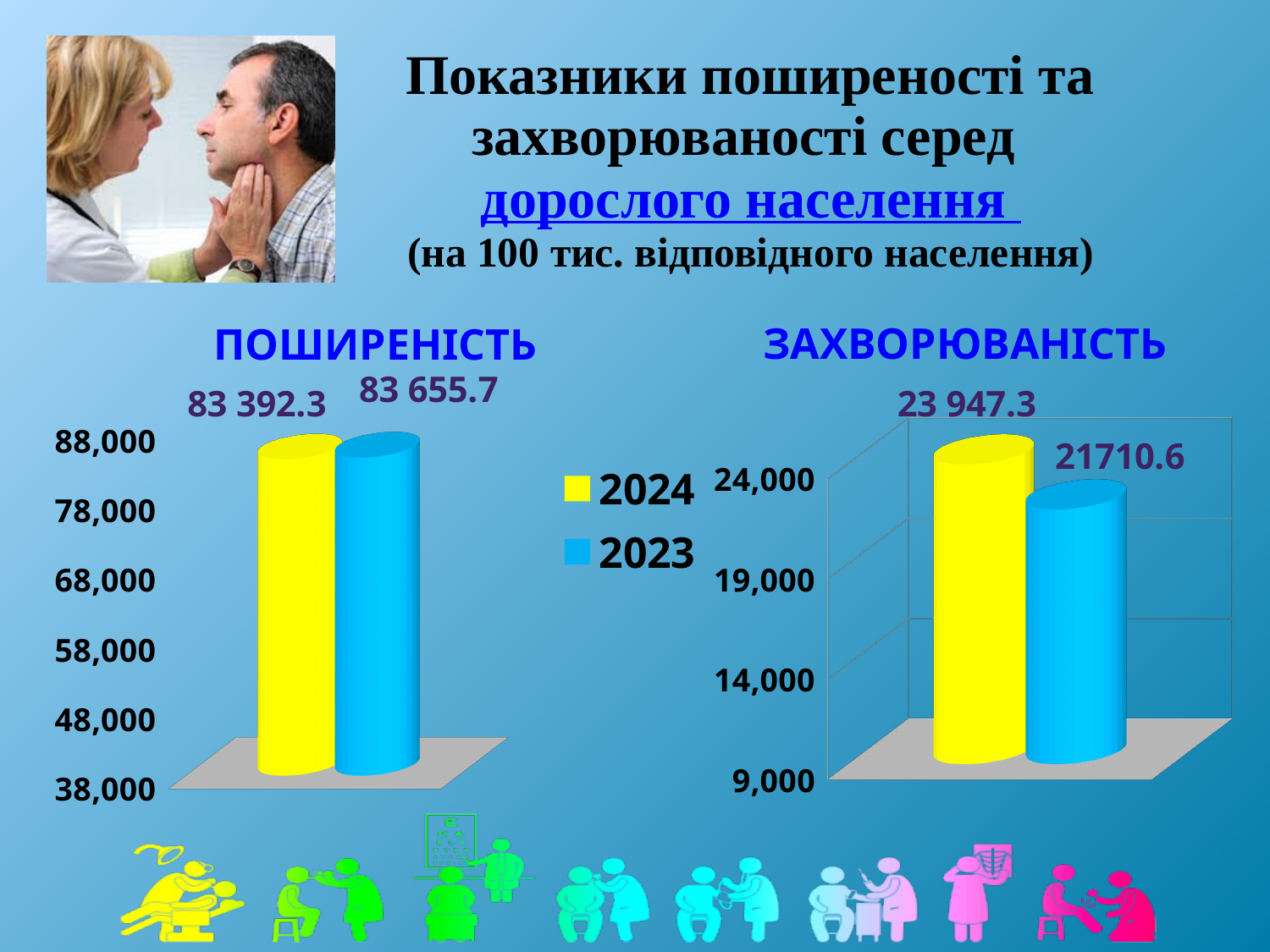
In the ЗАХВОРЮВАНІСТЬ chart, which year has the higher value? 2024 In the ПОШИРЕНІСТЬ chart, what is the value for 2023? 83 655.7 In the ПОШИРЕНІСТЬ chart, what is the value for 2024? 83 392.3 In the ПОШИРЕНІСТЬ chart, is the value for 2024 greater or less than 78,000? greater In the ЗАХВОРЮВАНІСТЬ chart, what is the difference between the 2024 and 2023 values? 2236.7 In the ЗАХВОРЮВАНІСТЬ chart, what is the value for 2024? 23 947.3 In the ПОШИРЕНІСТЬ chart, what is the difference between the 2023 and 2024 values? 263.4 In the ЗАХВОРЮВАНІСТЬ chart, what is the value for 2023? 21710.6 What kind of chart is the ЗАХВОРЮВАНІСТЬ chart? bar chart In the ЗАХВОРЮВАНІСТЬ chart, is the value for 2023 greater or less than 24,000? less In the ЗАХВОРЮВАНІСТЬ chart, which year has the lower value? 2023 How many series does the legend list? 2